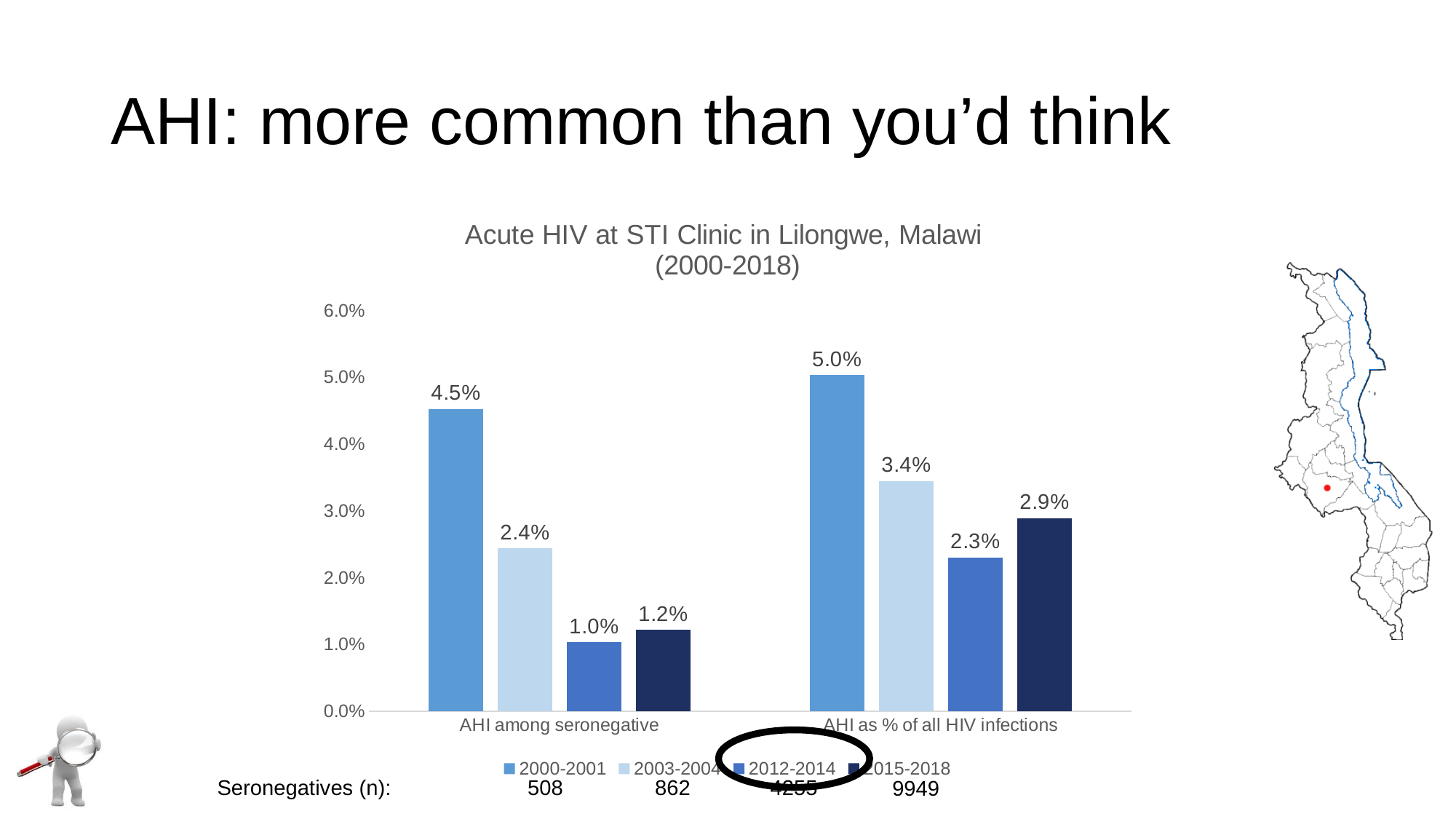
How many series does the legend list? 4 What kind of chart is shown on the slide? Bar chart Which period has the lowest value in the 'AHI among seronegative' category? 2012-2014 What is the title of the chart? Acute HIV at STI Clinic in Lilongwe, Malawi (2000-2018) What is the value for 2015-2018 in the 'AHI as % of all HIV infections' category? 2.9% What is the difference between the 2000-2001 and 2003-2004 values in the 'AHI among seronegative' category? 2.1% How many categories are shown on the x axis? 2 Which is larger: the 2003-2004 value for 'AHI as % of all HIV infections' or the 2015-2018 value for the same category? 2003-2004 What is the value for 2012-2014 in the 'AHI among seronegative' category? 1.0% What is the difference between the 2012-2014 and 2015-2018 values in the 'AHI as % of all HIV infections' category? 0.6% Which period has the highest value in the 'AHI as % of all HIV infections' category? 2000-2001 What is the value for 2000-2001 in the 'AHI among seronegative' category? 4.5%